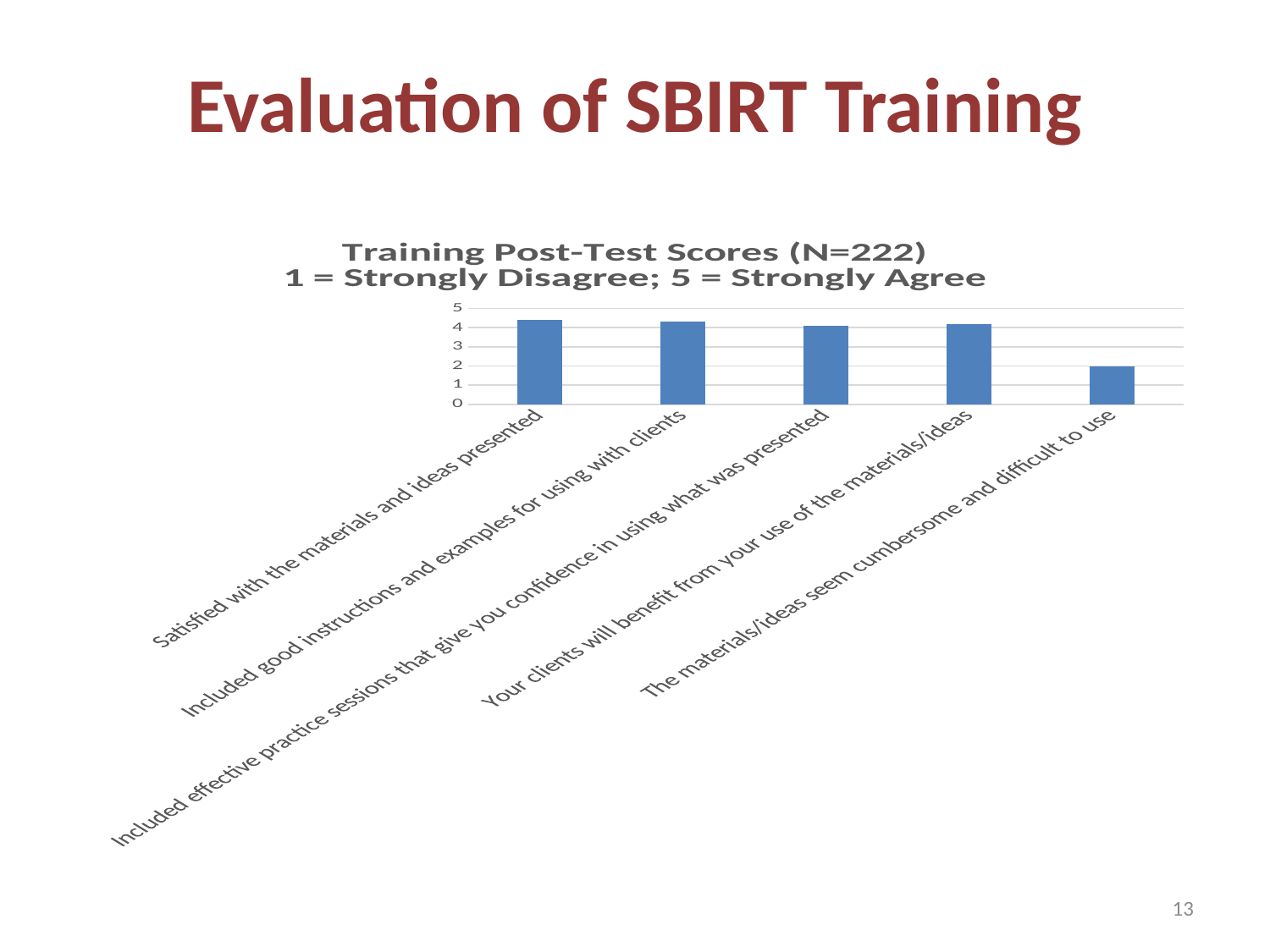
Is the score for "Satisfied with the materials and ideas presented" greater or less than 4? greater Which has the higher score: "The materials/ideas seem cumbersome and difficult to use" or "Included effective practice sessions that give you confidence in using what was presented"? Included effective practice sessions that give you confidence in using what was presented How many categories (statements) are plotted in the chart? 5 Is the score for "Your clients will benefit from your use of the materials/ideas" greater or less than 3? greater Which statement has the lowest score in the chart? The materials/ideas seem cumbersome and difficult to use What kind of chart is shown on the slide? Bar chart Which has the higher score: "Satisfied with the materials and ideas presented" or "The materials/ideas seem cumbersome and difficult to use"? Satisfied with the materials and ideas presented According to the chart subtitle, what does a score of 5 represent? Strongly Agree What is the title of the chart? Training Post-Test Scores (N=222) 1 = Strongly Disagree; 5 = Strongly Agree Is the score for "The materials/ideas seem cumbersome and difficult to use" greater or less than 3? less